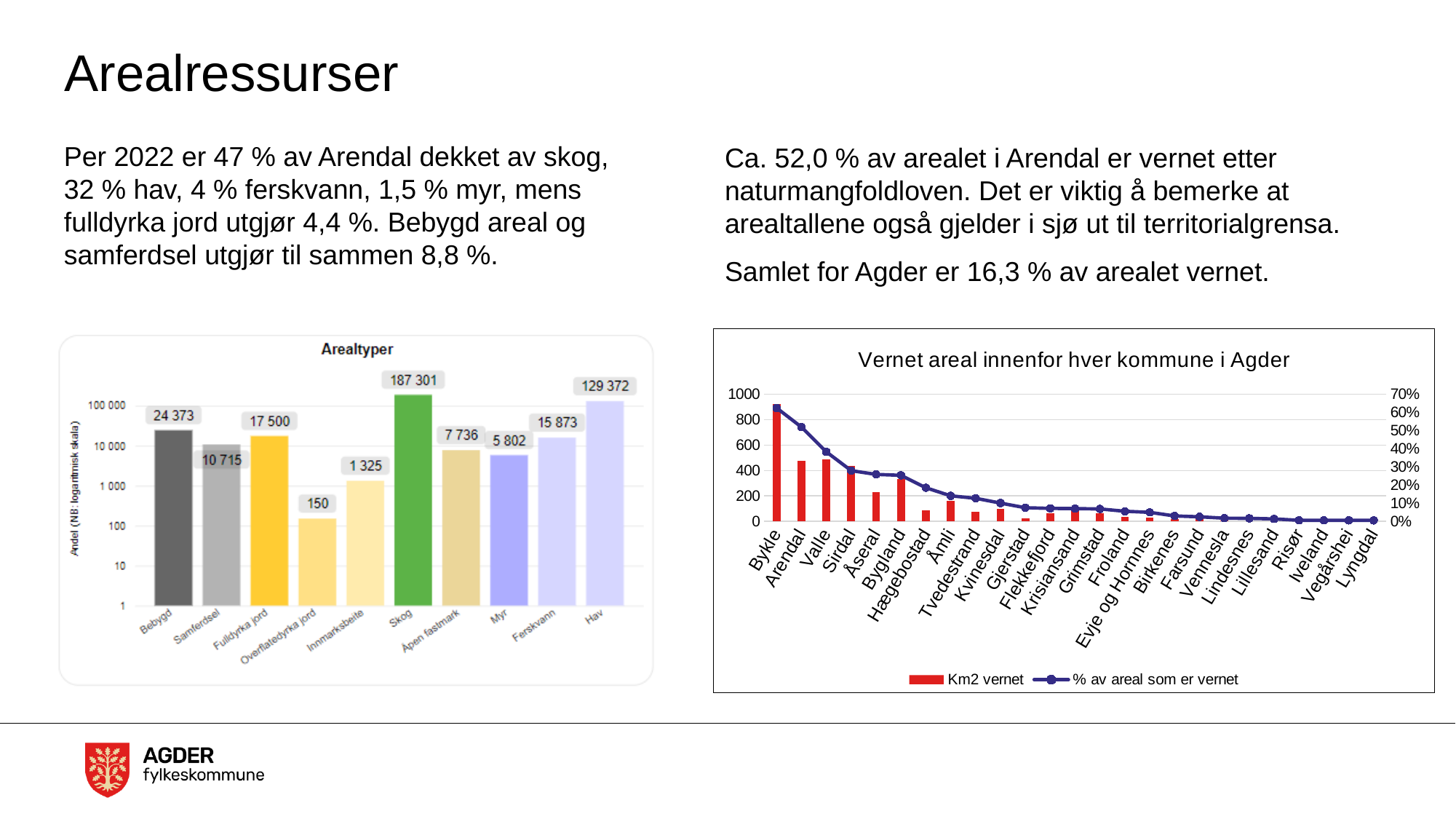
In the Arealtyper chart, which category has the lowest value? Overflatedyrka jord In the Arealtyper chart, what is the value for Skog? 187 301 In the Arealtyper chart, what is the difference between Bebygd and Samferdsel? 13 658 In the Arealtyper chart, which category has the highest value? Skog In the Arealtyper chart, what is the value for Overflatedyrka jord? 150 In the Arealtyper chart, which is larger, Fulldyrka jord or Ferskvann? Fulldyrka jord How many categories are shown in the Arealtyper chart? 10 How many municipalities are shown on the x axis of the chart titled 'Vernet areal innenfor hver kommune i Agder'? 25 In the chart titled 'Vernet areal innenfor hver kommune i Agder', how many series does the legend list? 2 In the chart titled 'Vernet areal innenfor hver kommune i Agder', does the '% av areal som er vernet' line rise or fall from left to right? fall In the chart titled 'Vernet areal innenfor hver kommune i Agder', is the Km2 vernet value for Bykle greater or less than 800? greater In the Arealtyper chart, what is the value for Ferskvann? 15 873